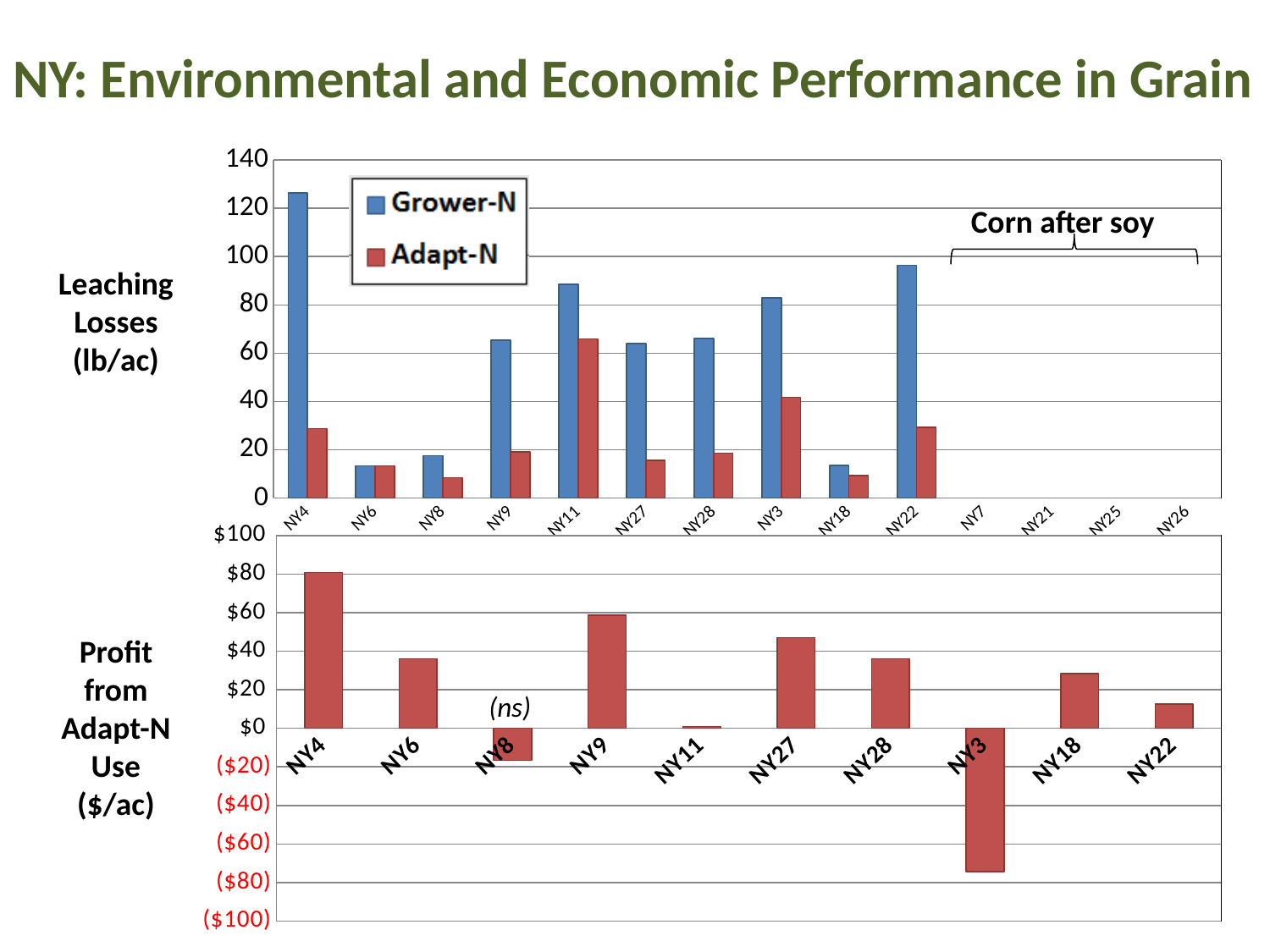
In the Profit from Adapt-N Use chart, which site has the lowest profit? NY3 In the Leaching Losses chart, how many series does the legend list? 2 In the Leaching Losses chart, which sites are grouped under the label 'Corn after soy'? NY7, NY21, NY25, NY26 In the Profit from Adapt-N Use chart, is the value for NY9 greater or less than $40? greater In the Leaching Losses chart, which site has the highest Grower-N leaching loss? NY4 In the Profit from Adapt-N Use chart, which site has the highest profit? NY4 In the Profit from Adapt-N Use chart, how many sites are shown on the x axis? 10 In the Leaching Losses chart, which site has the highest Adapt-N leaching loss? NY11 In the Leaching Losses chart, is the Adapt-N value for NY3 greater or less than 60? less In the Leaching Losses chart, is the Grower-N value for NY4 greater or less than 120? greater In the Leaching Losses chart, which is larger for NY4: the Grower-N value or the Adapt-N value? Grower-N